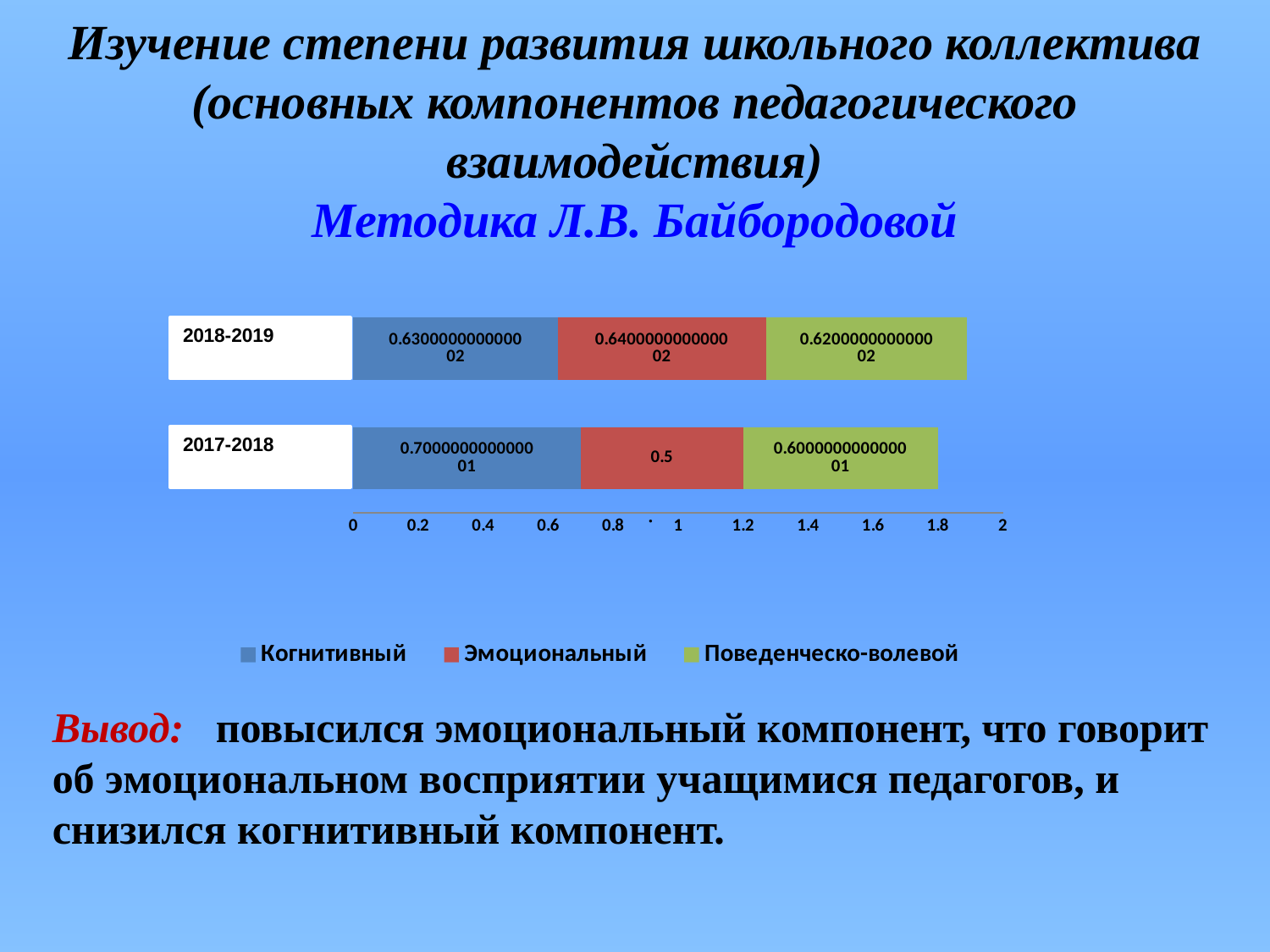
How many categories (school years) are shown on the chart? 2 What is the value of the Эмоциональный component for 2017-2018? 0.5 How many series does the chart legend list? 3 Which component has the highest value in 2018-2019? Эмоциональный Did the Эмоциональный component rise or fall from 2017-2018 to 2018-2019? Rise What is the value of the Когнитивный component for 2017-2018? 0.700000000000001 What is the value of the Эмоциональный component for 2018-2019? 0.640000000000002 What colour represents the Эмоциональный series in the legend? Red What type of chart is shown on the slide? Stacked bar chart Is the Когнитивный component larger in 2017-2018 or in 2018-2019? 2017-2018 Which component has the lowest value in 2017-2018? Эмоциональный Which component has the highest value in 2017-2018? Когнитивный